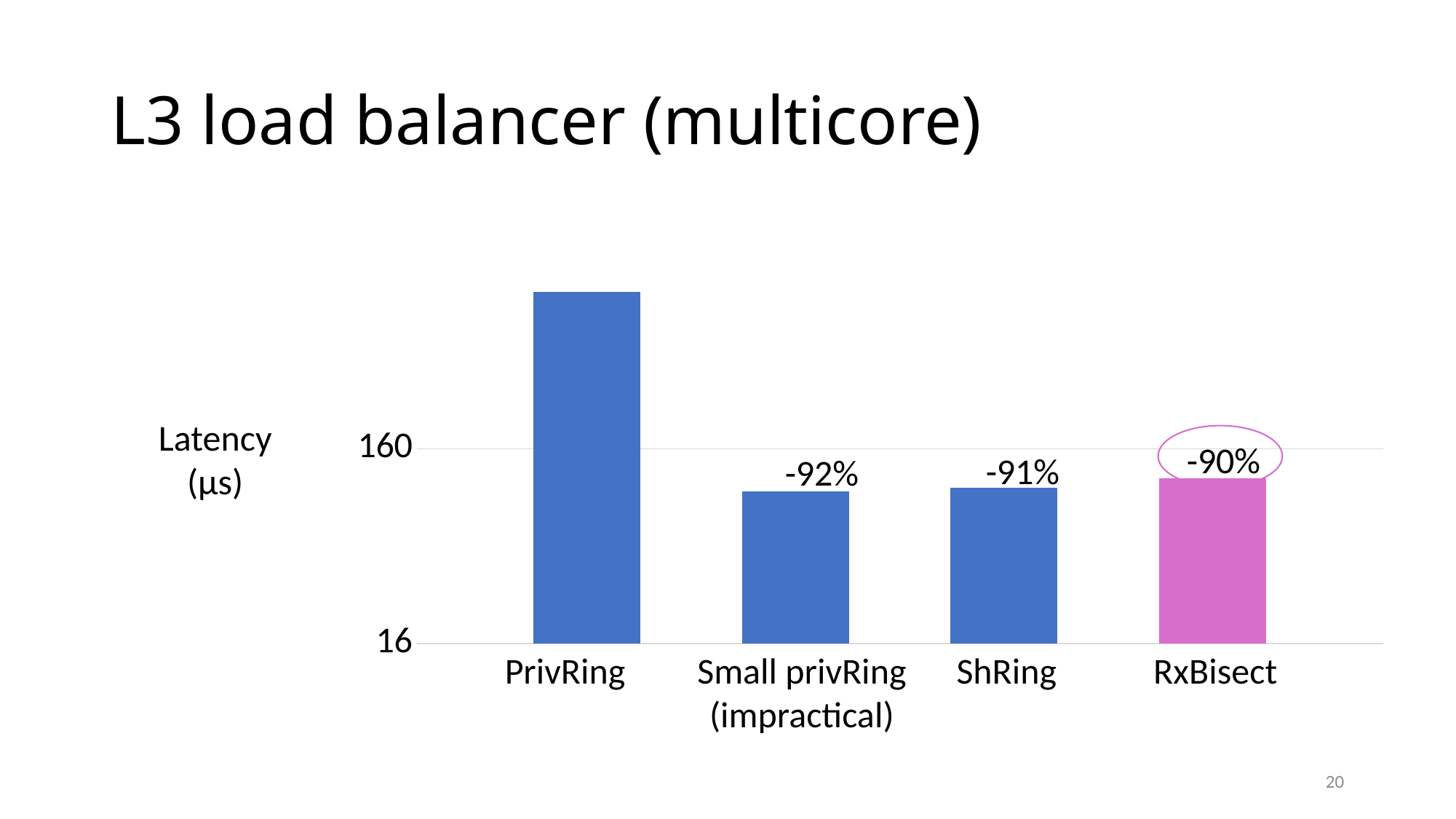
Which has the larger latency, PrivRing or RxBisect? PrivRing Is the latency for PrivRing greater or less than 160? greater Is the latency for RxBisect greater or less than 160? less Which category has the highest latency? PrivRing Is the latency for ShRing greater or less than 160? less What is the label on the y axis of the chart? Latency (µs) Which category's bar is coloured pink instead of blue? RxBisect What percentage label is printed above the ShRing bar? -91% What percentage label is printed above the RxBisect bar? -90% How many categories are plotted on the x axis? 4 What kind of chart is shown on the slide? bar chart What percentage label is printed above the Small privRing (impractical) bar? -92%